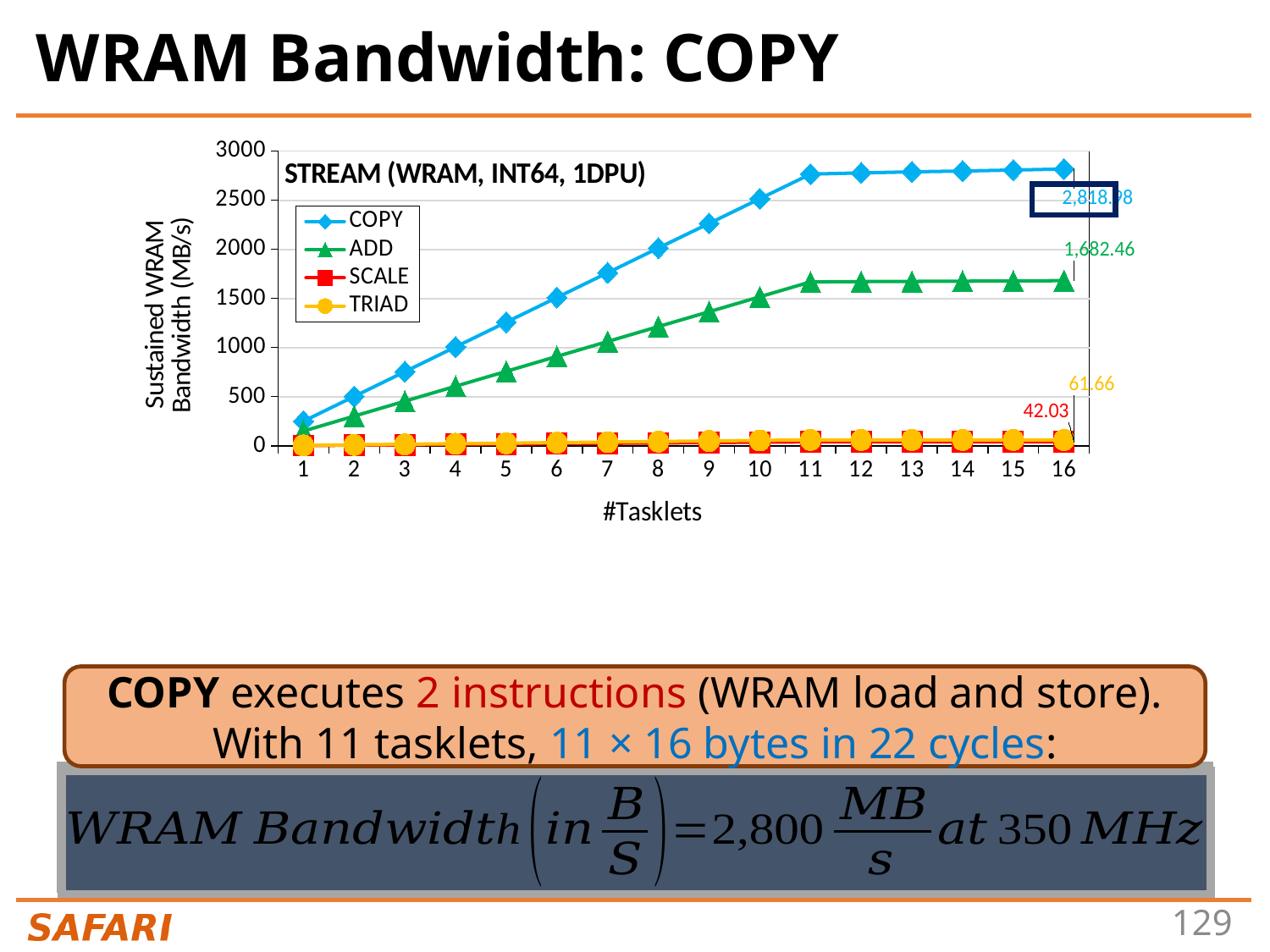
What is the sustained WRAM bandwidth for SCALE at 16 tasklets? 42.03 Is the ADD bandwidth at 5 tasklets greater or less than 1000? less How many tasklet values are plotted along the x axis? 16 How many series does the legend list? 4 What is the difference between the TRIAD and SCALE bandwidth values at 16 tasklets? 19.63 Which series has the highest bandwidth at 16 tasklets? COPY Is the COPY bandwidth at 11 tasklets greater or less than 2500? greater What is the sustained WRAM bandwidth for TRIAD at 16 tasklets? 61.66 What kind of chart is shown on the slide? line chart Which series has the lowest bandwidth at 16 tasklets? SCALE What is the sustained WRAM bandwidth for ADD at 16 tasklets? 1,682.46 What is the title shown inside the chart area? STREAM (WRAM, INT64, 1DPU)